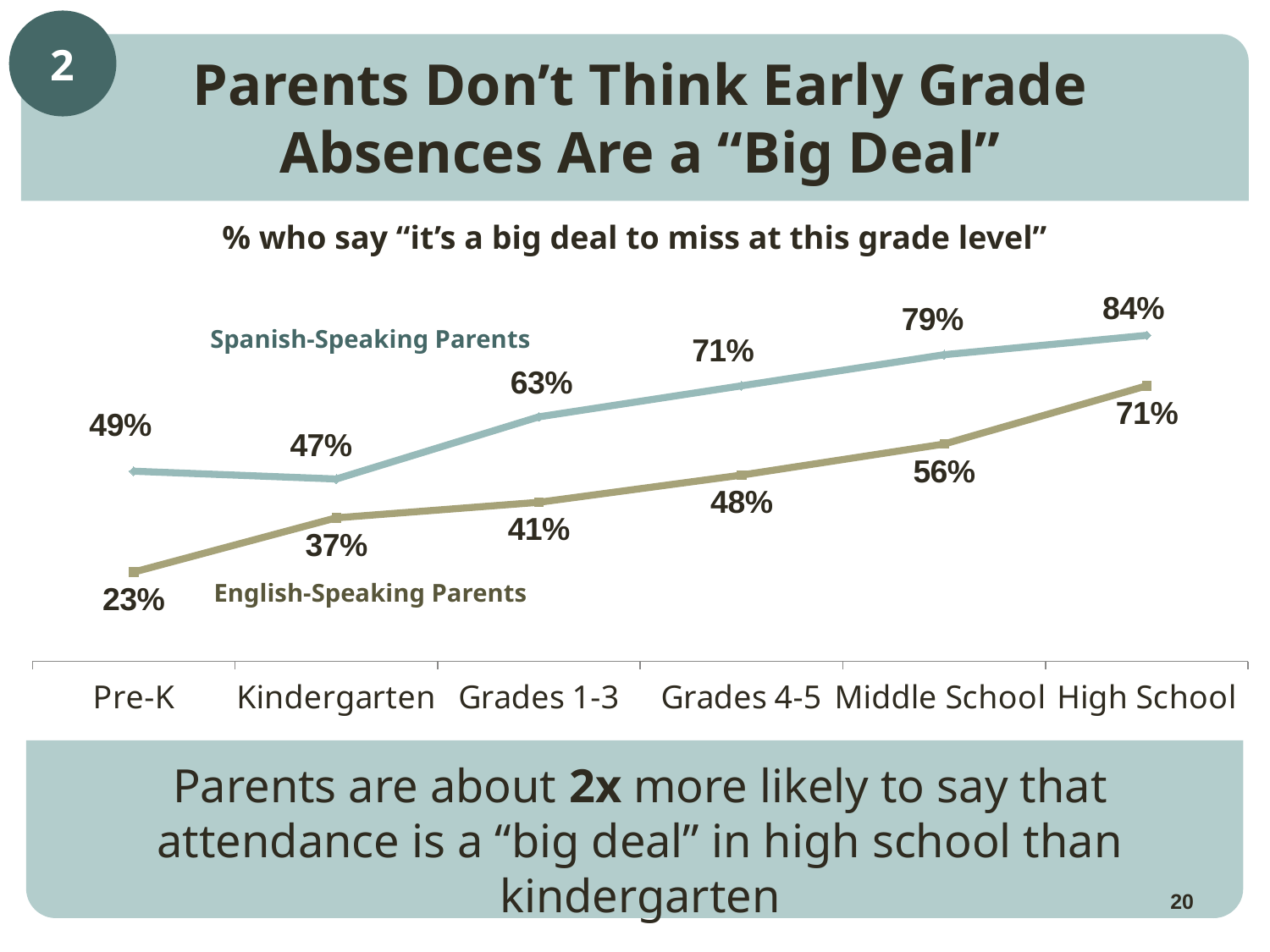
What percentage of English-Speaking Parents say it's a big deal to miss at Pre-K? 23% How many series are plotted on the chart? 2 How many grade levels are shown on the x axis? 6 What is the difference between the High School and Kindergarten values for English-Speaking Parents? 34% At which grade level is the value for Spanish-Speaking Parents highest? High School What kind of chart is shown on the slide? Line chart At which grade level is the value for English-Speaking Parents lowest? Pre-K Do the values for English-Speaking Parents rise or fall from Pre-K to High School? Rise Which group has the higher value at Grades 4-5, Spanish-Speaking Parents or English-Speaking Parents? Spanish-Speaking Parents What is the difference between Spanish-Speaking Parents and English-Speaking Parents at Kindergarten? 10% What percentage of English-Speaking Parents say it's a big deal to miss at Middle School? 56% What percentage of Spanish-Speaking Parents say it's a big deal to miss at Grades 1-3? 63%